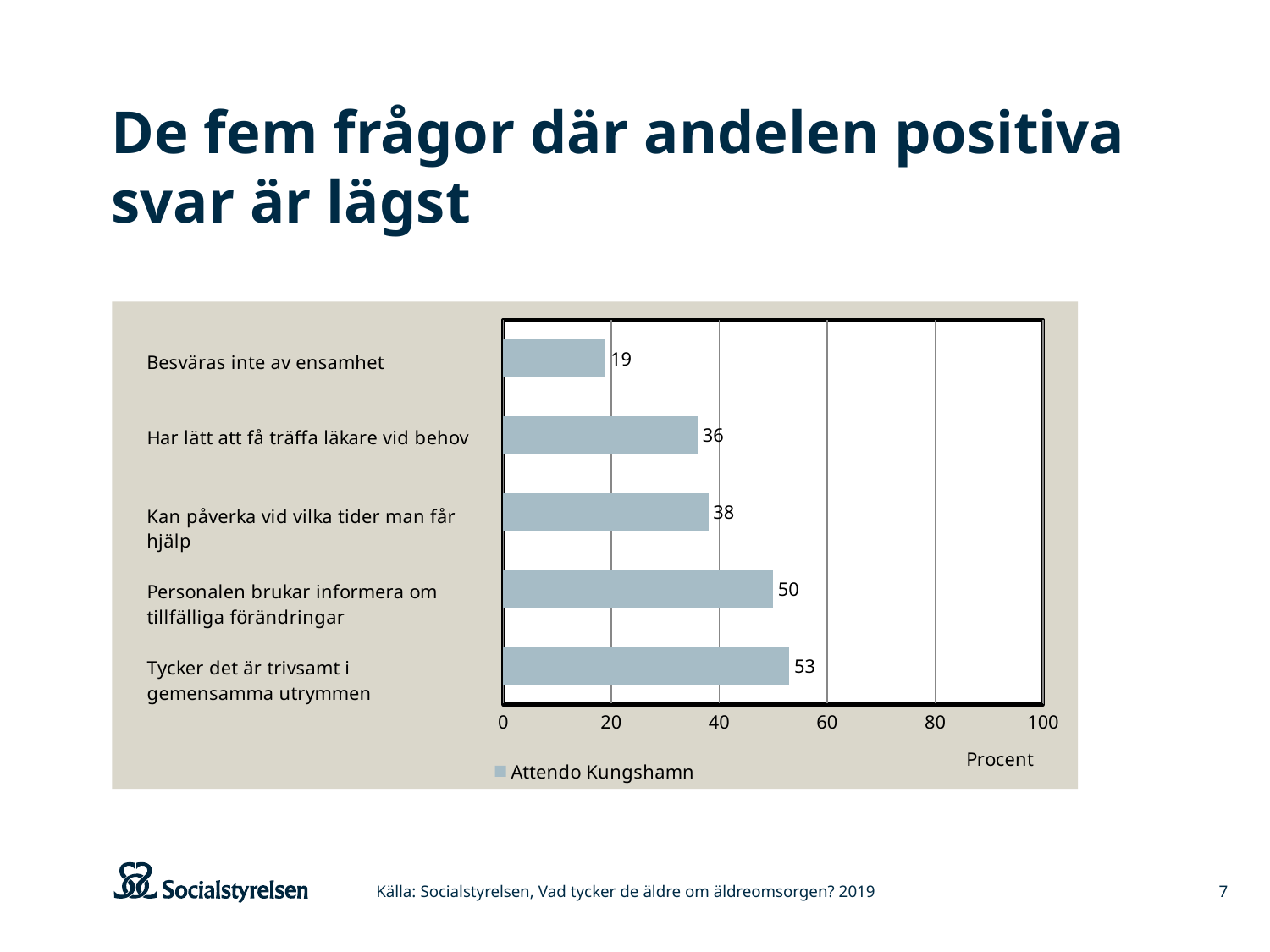
Which category has the lowest value? Besväras inte av ensamhet What is the value for "Besväras inte av ensamhet"? 19 What is the difference between the values for "Tycker det är trivsamt i gemensamma utrymmen" and "Besväras inte av ensamhet"? 34 What is the value for "Personalen brukar informera om tillfälliga förändringar"? 50 What series name is shown in the chart legend? Attendo Kungshamn How many categories are shown in the chart? 5 What kind of chart is shown on the slide? Bar chart Which is larger: the value for "Kan påverka vid vilka tider man får hjälp" or the value for "Har lätt att få träffa läkare vid behov"? Kan påverka vid vilka tider man får hjälp Is the value for "Personalen brukar informera om tillfälliga förändringar" greater or less than 40? greater How many series does the legend list? 1 Which category has the highest value? Tycker det är trivsamt i gemensamma utrymmen What is the value for "Har lätt att få träffa läkare vid behov"? 36